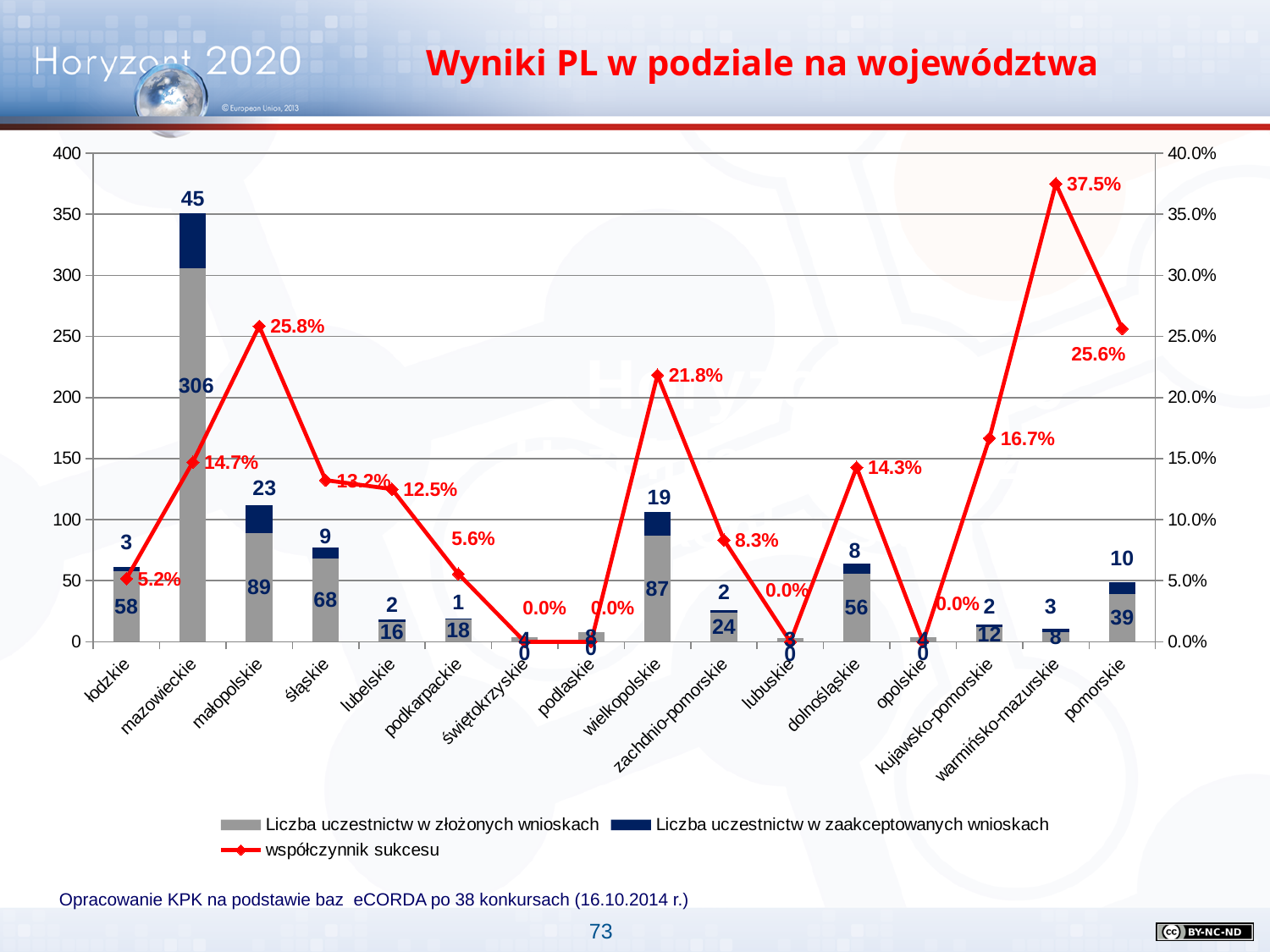
How many series does the legend list? 3 What is the value of 'Liczba uczestnictw w złożonych wnioskach' for mazowieckie? 306 What is the 'współczynnik sukcesu' for warmińsko-mazurskie? 37.5% How many województwa (categories) are shown on the x axis? 16 What is the total height of the stacked bar for mazowieckie (złożone plus zaakceptowane)? 351 Which województwo has the highest 'współczynnik sukcesu'? warmińsko-mazurskie What is the 'współczynnik sukcesu' for zachodnio-pomorskie? 8.3% What kind of chart is shown on the slide? A bar chart combined with a line chart What is the value of 'Liczba uczestnictw w zaakceptowanych wnioskach' for pomorskie? 10 Which has more 'Liczba uczestnictw w złożonych wnioskach', dolnośląskie or pomorskie? dolnośląskie Which województwo has the highest 'Liczba uczestnictw w złożonych wnioskach'? mazowieckie What is the difference in 'Liczba uczestnictw w złożonych wnioskach' between mazowieckie and małopolskie? 217